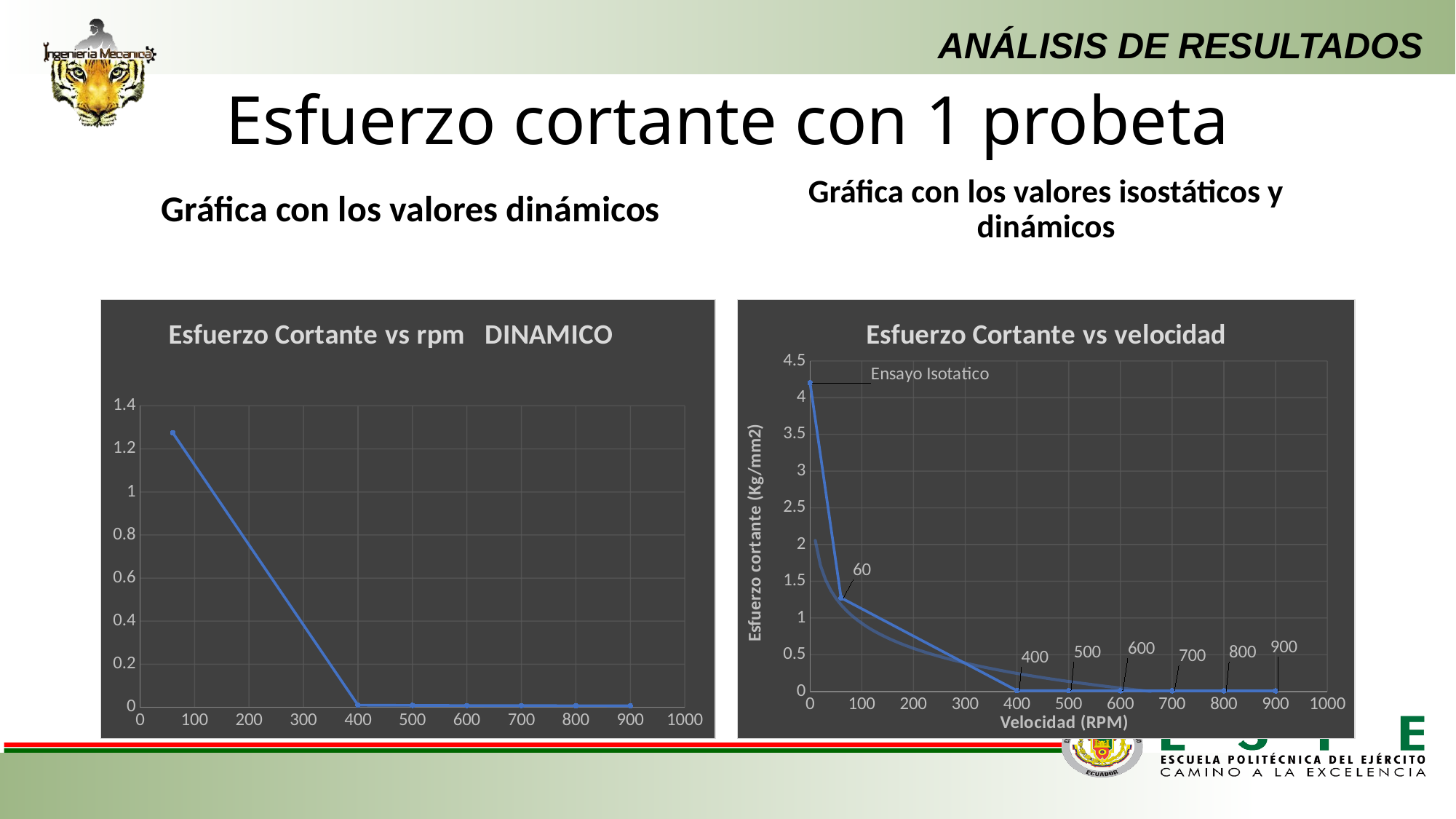
In the left chart 'Esfuerzo Cortante vs rpm DINAMICO', is the value at 400 rpm greater or less than 0.2? less In the right chart 'Esfuerzo Cortante vs velocidad', which is larger: the value at the point labelled 60 or the value at the point labelled 400? 60 What kind of chart is the left chart titled 'Esfuerzo Cortante vs rpm DINAMICO'? line chart In the left chart 'Esfuerzo Cortante vs rpm DINAMICO', do the values rise or fall as rpm increases along the x axis? fall In the left chart 'Esfuerzo Cortante vs rpm DINAMICO', is the value at the first plotted point (near 60 rpm) greater or less than 1? greater How many data points are plotted in the left chart 'Esfuerzo Cortante vs rpm DINAMICO'? 7 In the left chart 'Esfuerzo Cortante vs rpm DINAMICO', is the value at the first plotted point (near 60 rpm) greater or less than 1.4? less What kind of chart is the right chart titled 'Esfuerzo Cortante vs velocidad'? line chart What is the y-axis title of the right chart 'Esfuerzo Cortante vs velocidad'? Esfuerzo cortante (Kg/mm2) In the right chart 'Esfuerzo Cortante vs velocidad', which labelled point has the highest shear stress value? Ensayo Isotatico